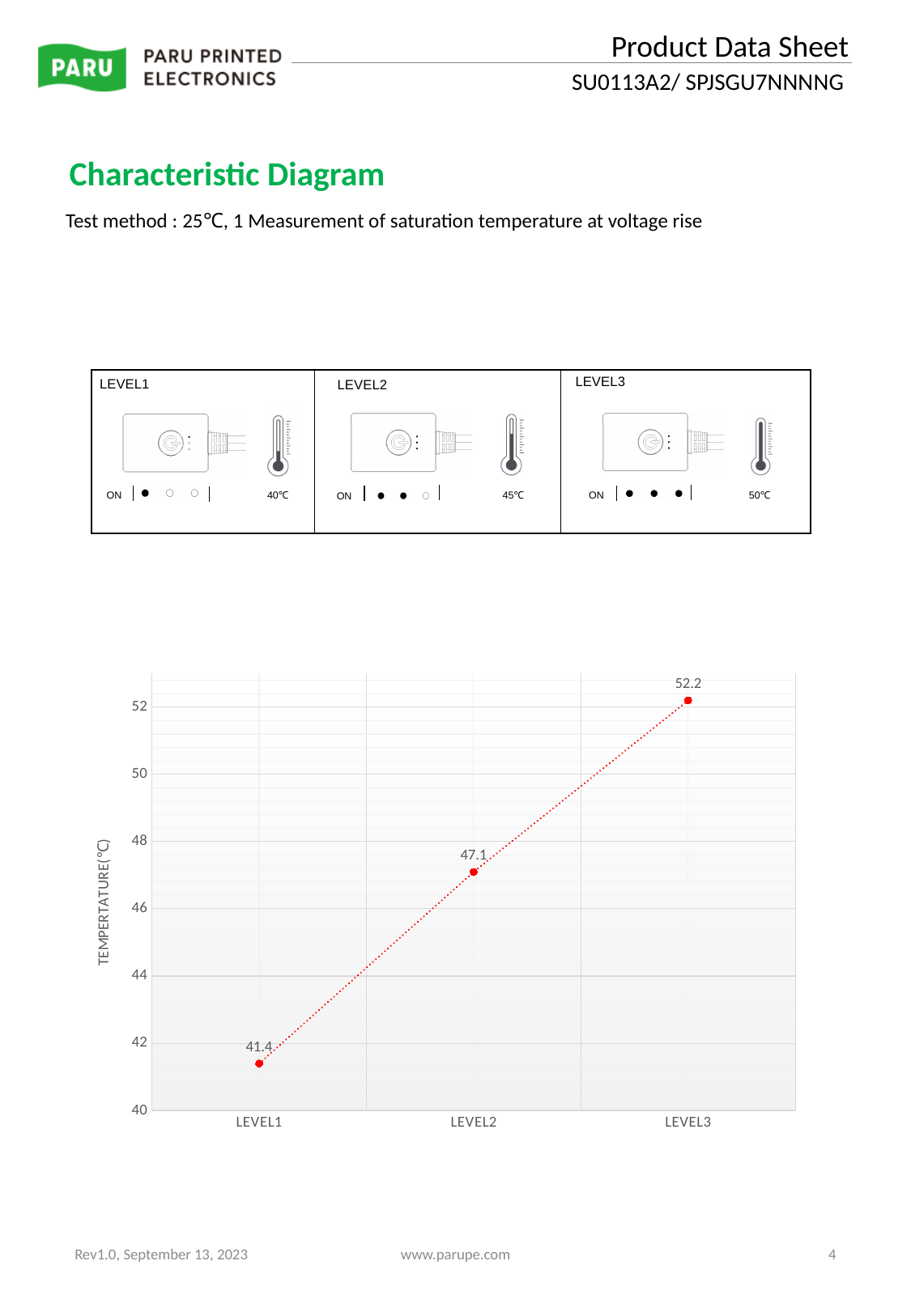
Is the plotted value for LEVEL2 greater or less than 46? greater Do the plotted temperatures rise or fall from LEVEL1 to LEVEL3? rise Which level has the highest plotted temperature? LEVEL3 What is the temperature value plotted for LEVEL3? 52.2 What is the difference between the plotted temperatures for LEVEL3 and LEVEL1? 10.8 What is the difference between the plotted temperatures for LEVEL2 and LEVEL1? 5.7 What is the label of the chart's y axis? TEMPERTATURE(℃) Which level has the lowest plotted temperature? LEVEL1 What is the temperature value plotted for LEVEL2? 47.1 What is the temperature value plotted for LEVEL1? 41.4 How many levels are plotted on the x axis of the chart? 3 Which has a larger plotted temperature, LEVEL2 or LEVEL3? LEVEL3